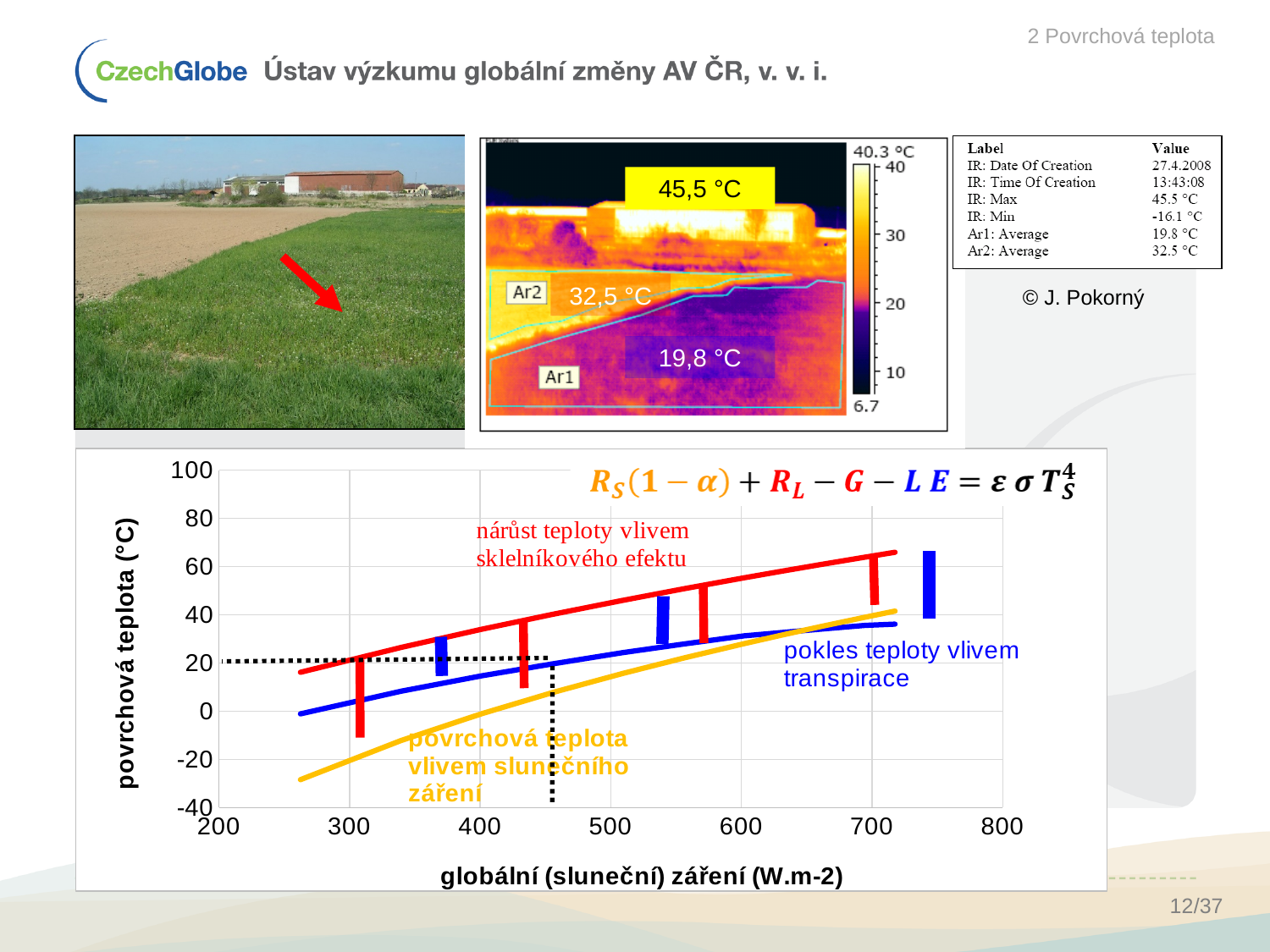
How many curves are plotted in the line chart at the bottom of the slide? 3 What is the title of the x axis of the line chart? globální (sluneční) záření (W.m-2) In the line chart, is the value of the red curve at 700 W.m-2 greater or less than 60 °C? greater In the line chart, which curve lies highest across the whole x range: the red, blue or yellow one? red What is the title of the y axis of the line chart? povrchová teplota (°C) In the line chart, do the curves rise or fall as global radiation increases along the x axis? rise In the line chart, at 700 W.m-2, is the red curve above or below the blue curve? above In the line chart, which curve lies lowest across the whole x range: the red, blue or yellow one? yellow In the line chart, is the value of the blue curve at 300 W.m-2 greater or less than 20 °C? less What kind of chart is shown at the bottom of the slide? line chart In the line chart, is the value of the yellow curve at 300 W.m-2 greater or less than 0 °C? less